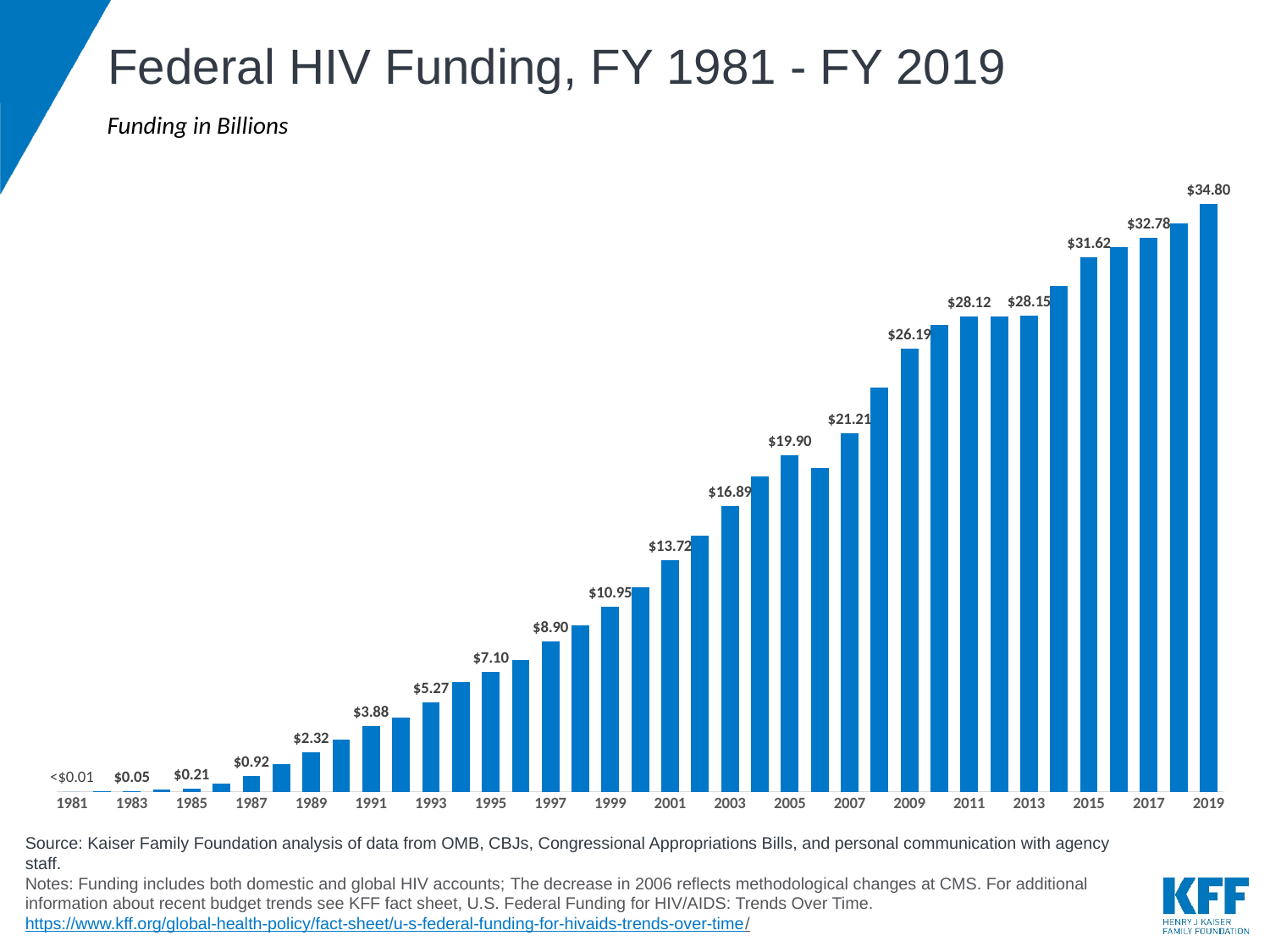
Which fiscal year has the highest federal HIV funding on the chart? 2019 How many fiscal years (bars) are plotted on the chart? 39 What is the funding value labeled for FY 1995? $7.10 Which fiscal year has the lowest federal HIV funding on the chart? 1981 What is the difference between the funding values for FY 2019 and FY 2017? $2.02 What is the funding value labeled for FY 1981? <$0.01 What is the overall trend in federal HIV funding from FY 1981 to FY 2019? Rising What is the difference between the funding values for FY 2001 and FY 1999? $2.77 What is the federal HIV funding value shown for FY 2019? $34.80 What is the funding value labeled for FY 2009? $26.19 Which is larger, the funding for FY 2005 or FY 2007? FY 2007 What type of chart is used on this slide? Bar chart